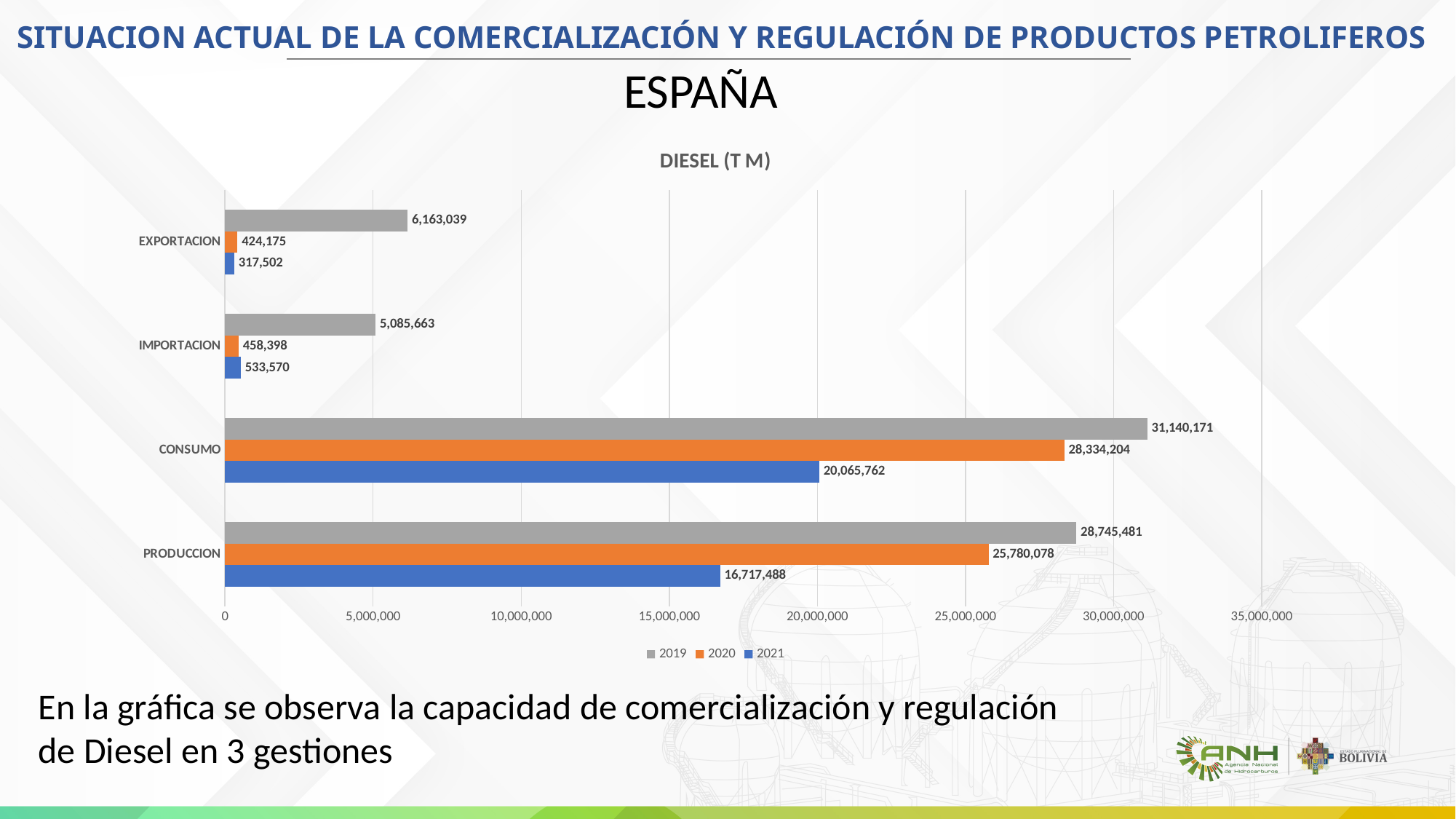
Which is larger: IMPORTACION in 2020 or IMPORTACION in 2021? IMPORTACION in 2021 Which category has the lowest value in 2021? EXPORTACION How many series does the legend list? 3 Which category has the highest value in 2019? CONSUMO What is the value for EXPORTACION in 2020? 424,175 How many categories are shown on the chart? 4 What is the title of the chart? DIESEL (T M) Is the value for PRODUCCION in 2020 greater or less than 25,000,000? greater What is the value for CONSUMO in 2019? 31,140,171 What is the difference between the 2019 and 2020 values for CONSUMO? 2,805,967 What type of chart is shown on the slide? Bar chart What is the value for PRODUCCION in 2021? 16,717,488